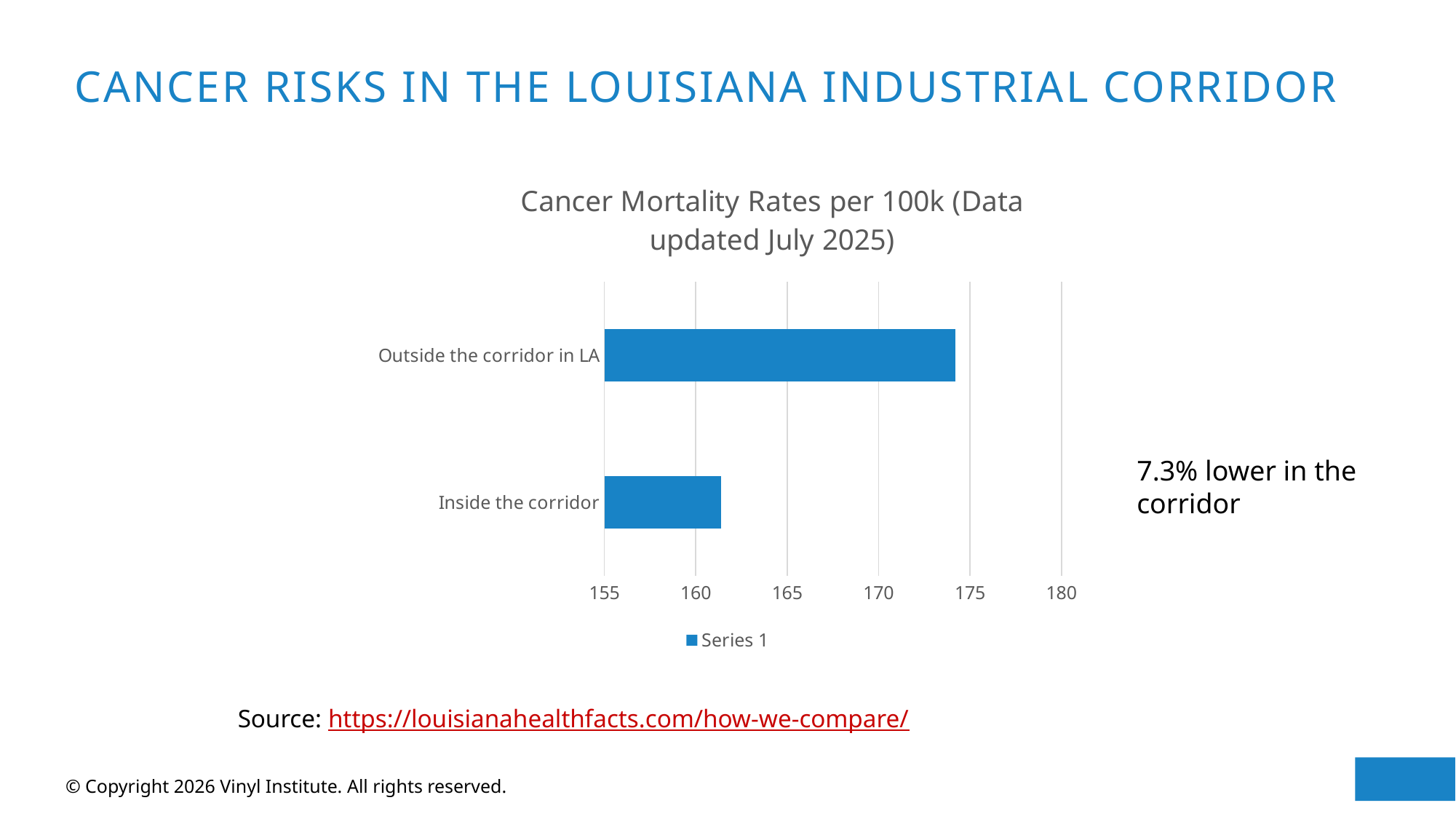
Is the value for Inside the corridor greater or less than 165? less Which is larger, the value for Outside the corridor in LA or the value for Inside the corridor? Outside the corridor in LA Is the value for Outside the corridor in LA greater or less than 170? greater What is the name of the series shown in the legend? Series 1 Is the value for Inside the corridor greater or less than 160? greater What kind of chart is shown on the slide? bar chart How many series does the legend list? 1 What is the title of the chart? Cancer Mortality Rates per 100k (Data updated July 2025) How many categories are plotted in the chart? 2 Which category has the highest cancer mortality rate? Outside the corridor in LA Which category has the lowest cancer mortality rate? Inside the corridor